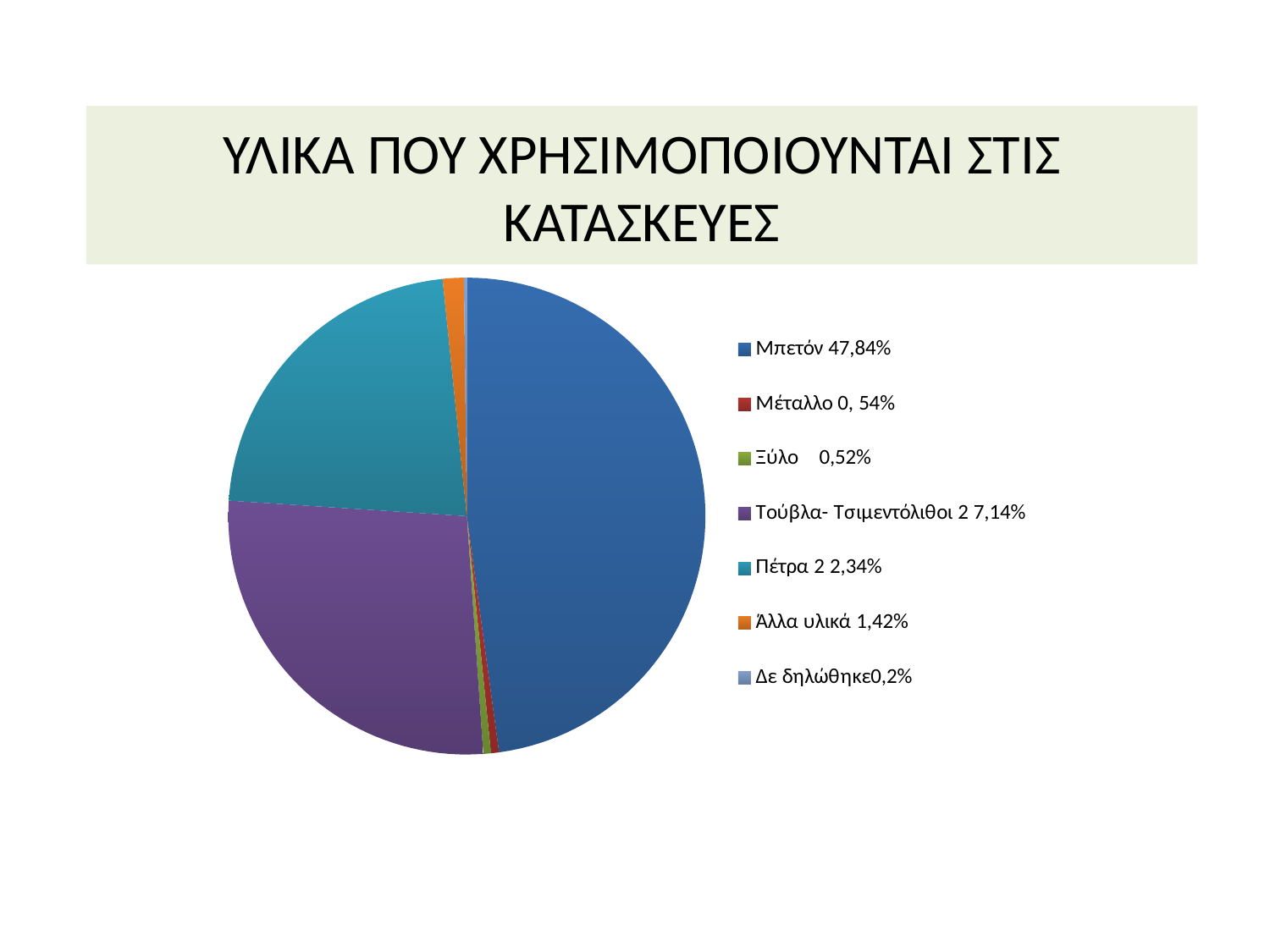
What colour is the slice for Μπετόν? blue How many categories does the pie chart have? 7 What percentage is shown for Μπετόν? 47,84% Which has a larger share, Τούβλα- Τσιμεντόλιθοι or Πέτρα? Τούβλα- Τσιμεντόλιθοι What is the title of the chart? ΥΛΙΚΑ ΠΟΥ ΧΡΗΣΙΜΟΠΟΙΟΥΝΤΑΙ ΣΤΙΣ ΚΑΤΑΣΚΕΥΕΣ Which category has the largest share of the pie? Μπετόν What is the difference in percentage points between Μπετόν and Άλλα υλικά? 46,42% What type of chart is shown on the slide? pie chart What percentage is shown for Ξύλο? 0,52% Which category has the smallest share of the pie? Δε δηλώθηκε What percentage is shown for Δε δηλώθηκε? 0,2% What percentage is shown for Άλλα υλικά? 1,42%